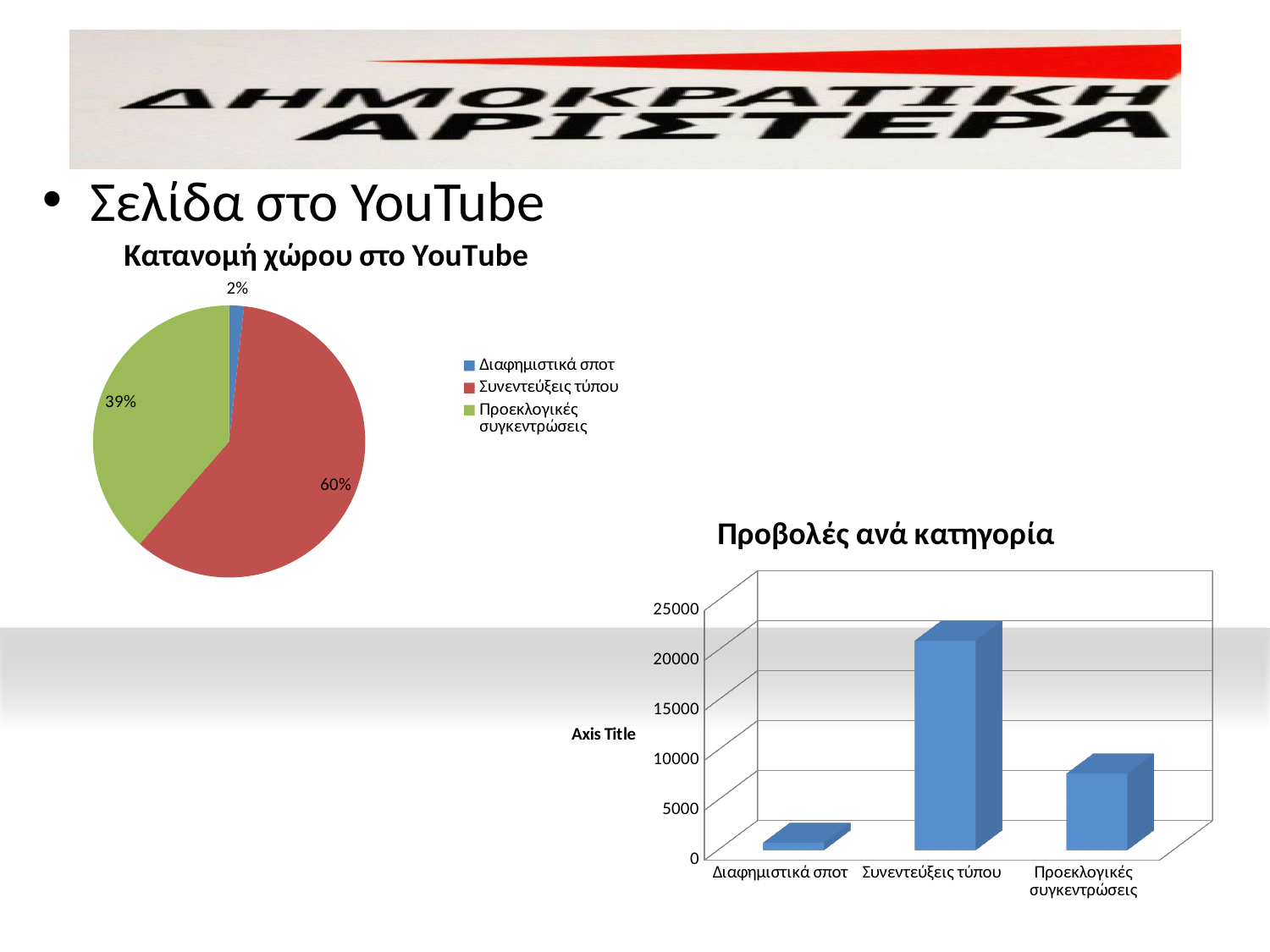
In the bar chart 'Προβολές ανά κατηγορία', is the value for Προεκλογικές συγκεντρώσεις greater or less than 10000? less In the bar chart 'Προβολές ανά κατηγορία', is the value for Συνεντεύξεις τύπου greater or less than 15000? greater In the pie chart 'Κατανομή χώρου στο YouTube', which category has the largest slice? Συνεντεύξεις τύπου In the bar chart 'Προβολές ανά κατηγορία', which category has the highest value? Συνεντεύξεις τύπου In the pie chart 'Κατανομή χώρου στο YouTube', what share does Διαφημιστικά σποτ have? 2% In the pie chart 'Κατανομή χώρου στο YouTube', what is the difference in percentage points between Συνεντεύξεις τύπου and Προεκλογικές συγκεντρώσεις? 21 In the pie chart 'Κατανομή χώρου στο YouTube', what share does Συνεντεύξεις τύπου have? 60% In the pie chart 'Κατανομή χώρου στο YouTube', which category has the smallest slice? Διαφημιστικά σποτ What kind of chart is 'Προβολές ανά κατηγορία'? bar chart In the pie chart 'Κατανομή χώρου στο YouTube', what share does Προεκλογικές συγκεντρώσεις have? 39% How many entries does the legend of the pie chart 'Κατανομή χώρου στο YouTube' list? 3 How many categories are shown in the bar chart 'Προβολές ανά κατηγορία'? 3